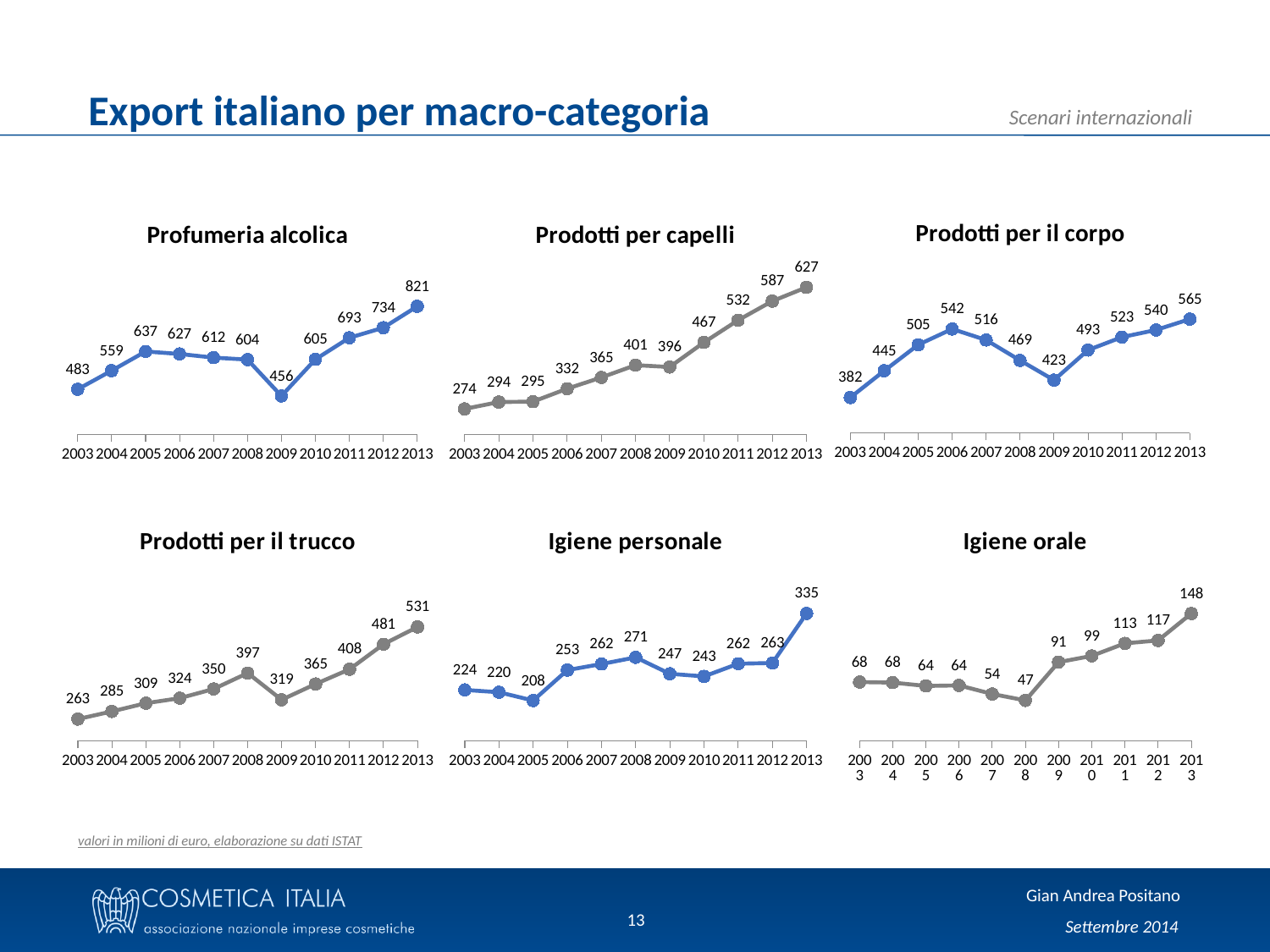
How many data points are plotted in the 'Igiene personale' chart? 11 In the 'Prodotti per capelli' chart, what is the difference between the 2013 value and the 2012 value? 40 In the 'Prodotti per il corpo' chart, which year has the highest value? 2013 In the 'Prodotti per capelli' chart, what is the value for 2003? 274 In the 'Igiene personale' chart, what is the value for 2005? 208 In the 'Igiene orale' chart, which year has the lowest value? 2008 What kind of chart is 'Prodotti per il trucco'? Line chart In the 'Profumeria alcolica' chart, what is the value for 2013? 821 In the 'Prodotti per il corpo' chart, what is the value for 2009? 423 In the 'Prodotti per il trucco' chart, which is larger, the value for 2008 or the value for 2009? 2008 In the 'Igiene orale' chart, what is the difference between the 2013 value and the 2003 value? 80 In the 'Profumeria alcolica' chart, which year has the lowest value? 2009